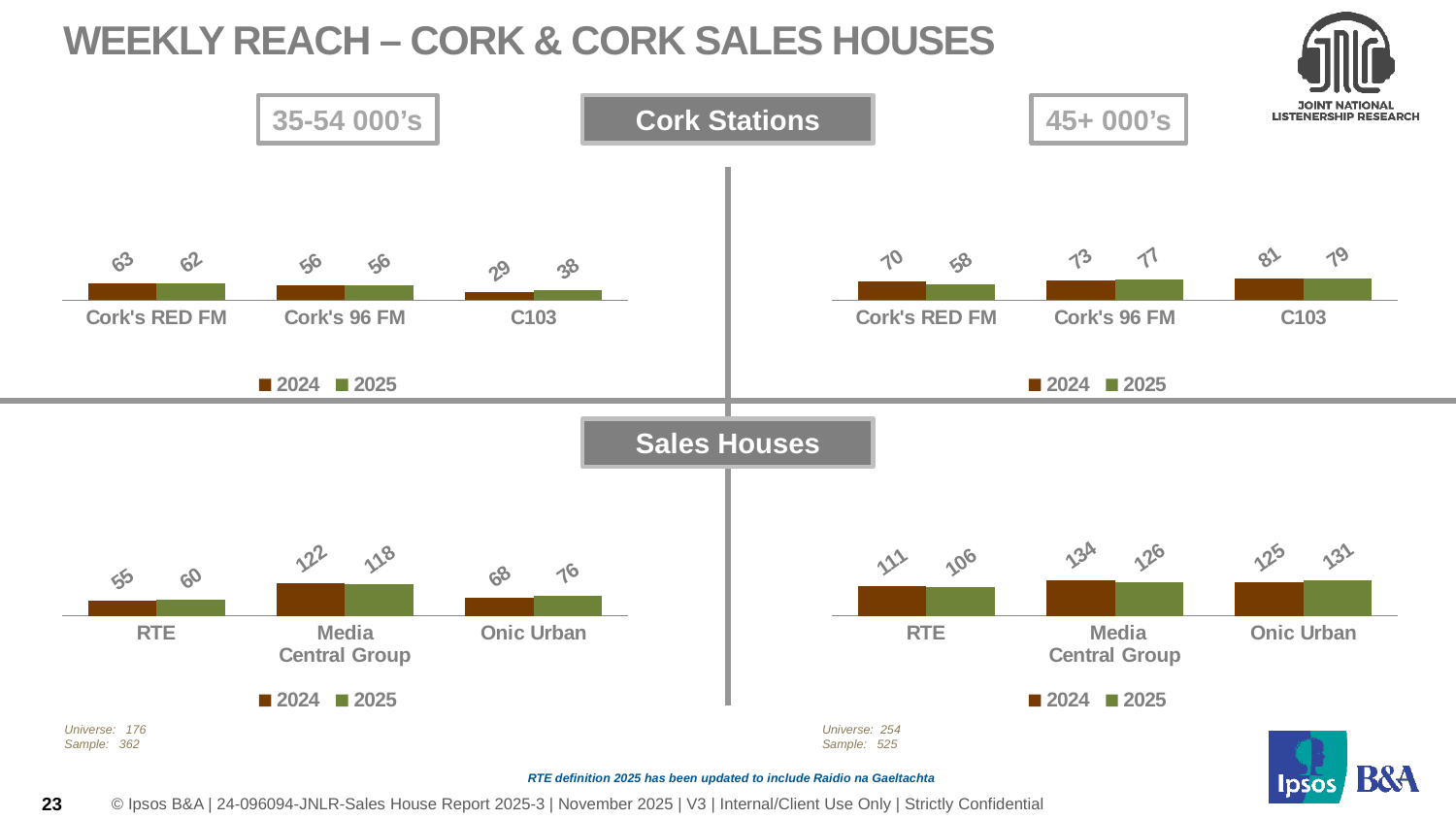
In the top-left Cork Stations chart (35-54 000's), what is the 2025 value for C103? 38 How many stations are shown in the top-right Cork Stations chart (45+ 000's)? 3 In the bottom-left Sales Houses chart (35-54 000's), which sales house has the lowest 2025 value? RTE In the bottom-right Sales Houses chart (45+ 000's), is the 2024 value for Media Central Group larger or smaller than its 2025 value? larger How many series does the legend list in the top-left Cork Stations chart? 2 In the bottom-right Sales Houses chart (45+ 000's), what is the 2025 value for Onic Urban? 131 In the bottom-right Sales Houses chart (45+ 000's), what is the difference between the 2024 and 2025 values for RTE? 5 What type of chart is the bottom-left Sales Houses chart? Bar chart In the top-left Cork Stations chart (35-54 000's), what is the 2024 value for Cork's RED FM? 63 In the top-right Cork Stations chart (45+ 000's), which station has the highest 2024 value? C103 In the top-right Cork Stations chart (45+ 000's), what is the difference between the 2024 and 2025 values for Cork's RED FM? 12 In the bottom-left Sales Houses chart (35-54 000's), what is the 2024 value for Media Central Group? 122